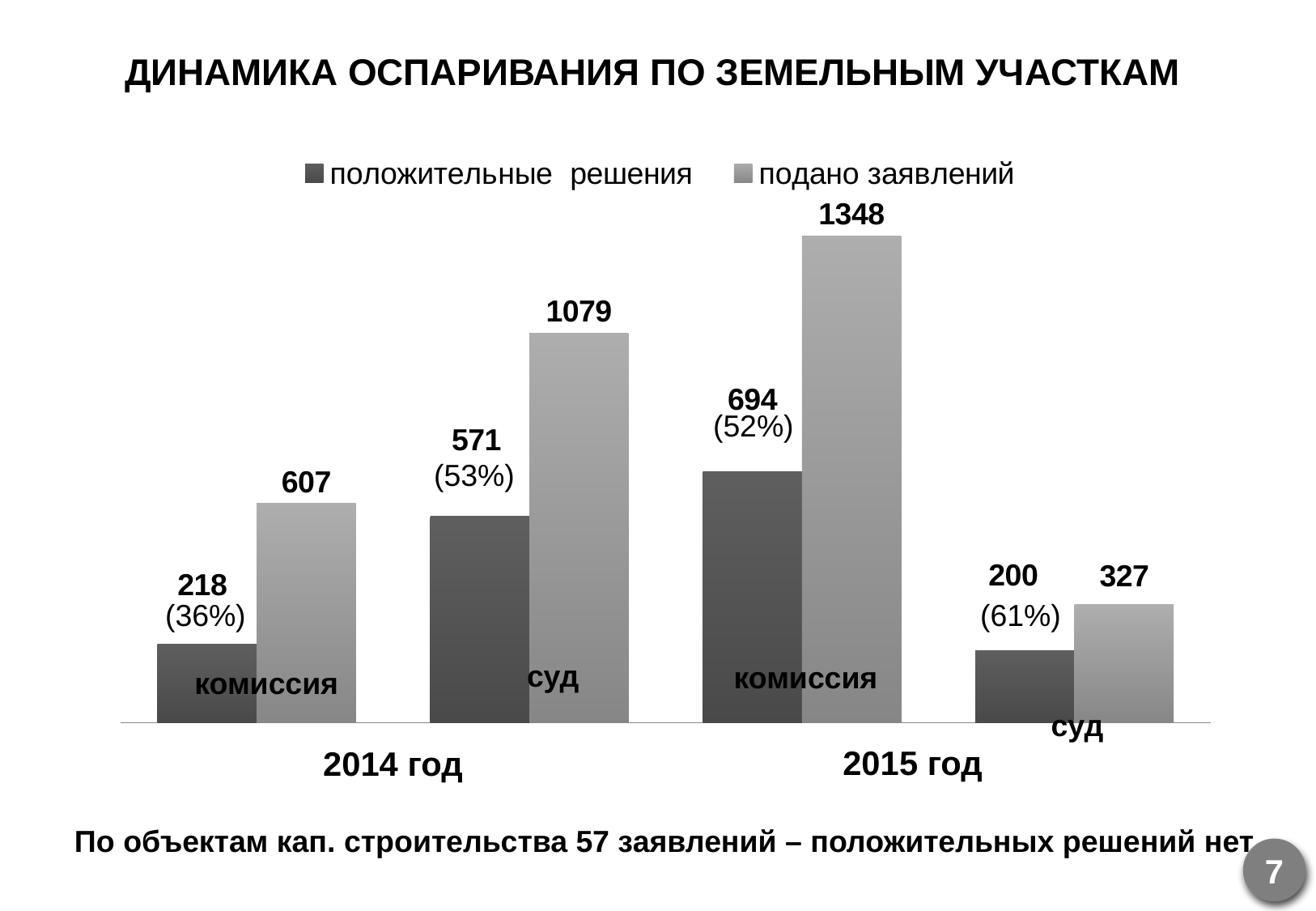
Which is larger: positive decisions for the комиссия in 2014 or positive decisions for the суд in 2014? суд in 2014 What is the difference between applications submitted and positive decisions for the комиссия in 2015? 654 What percentage is shown next to the positive decisions for the суд in 2015? 61% How many series does the legend list? 2 What is the title of the slide? ДИНАМИКА ОСПАРИВАНИЯ ПО ЗЕМЕЛЬНЫМ УЧАСТКАМ Which category has the lowest number of positive decisions (положительные решения)? суд, 2015 год How many positive decisions (положительные решения) were made by the суд in 2014? 571 How many category groups (bar pairs) are plotted on the chart? 4 How many applications were submitted (подано заявлений) to the комиссия in 2014? 607 Which category has the highest number of submitted applications (подано заявлений)? комиссия, 2015 год What kind of chart is shown on the slide? bar chart How many applications were submitted (подано заявлений) to the комиссия in 2015? 1348